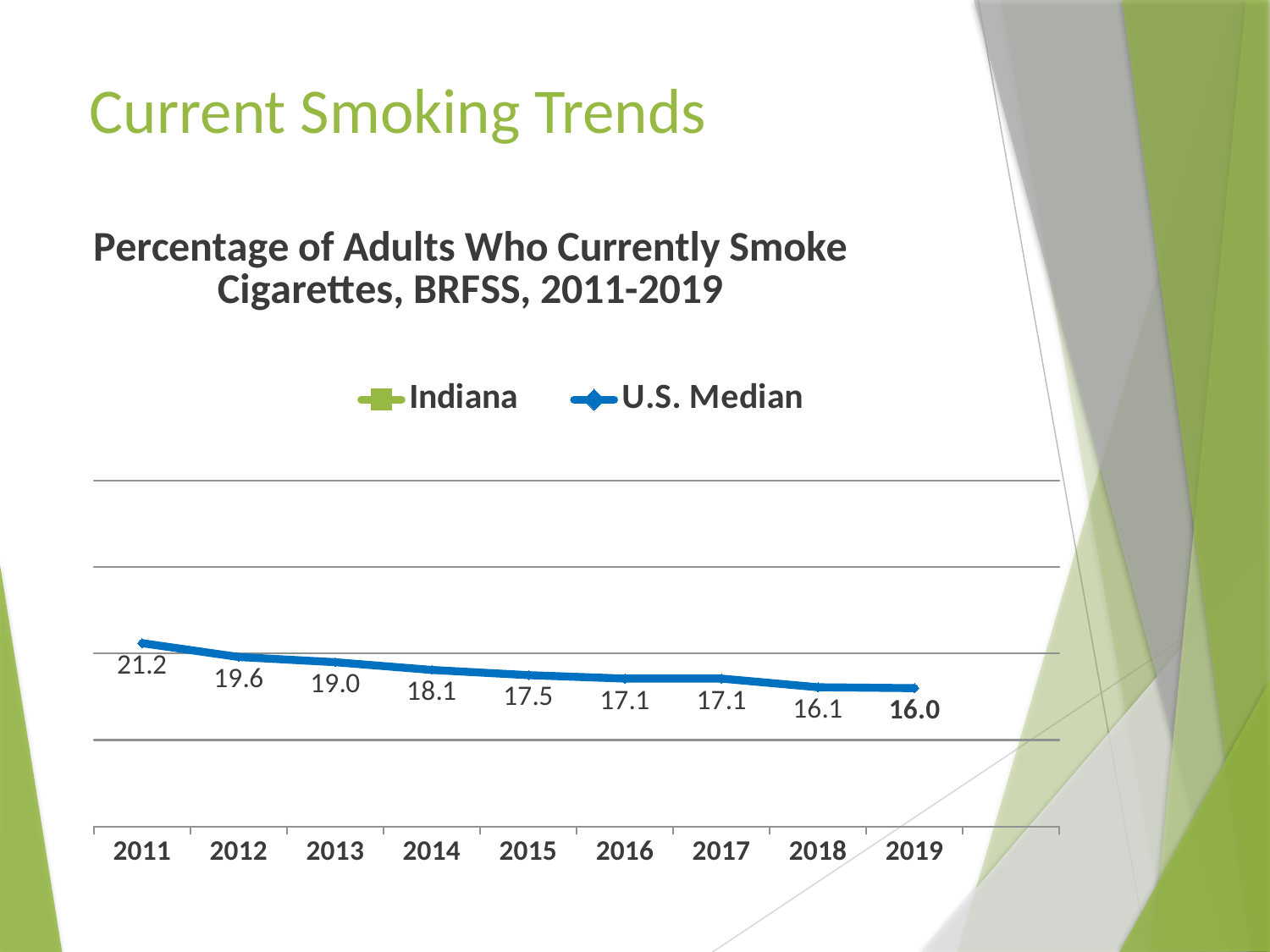
Which year has the larger labelled value, 2012 or 2018? 2012 What value is labelled for 2011 on the plotted line? 21.2 What value is labelled for 2014 on the plotted line? 18.1 What value is labelled for 2019 on the plotted line? 16.0 How many series does the legend list? 2 Which year has the highest labelled value? 2011 What is the difference between the labelled values for 2011 and 2019? 5.2 Which year has the lowest labelled value? 2019 What are the two series named in the legend? Indiana and U.S. Median How many years are shown on the x axis? 9 What kind of chart is shown? line chart Do the labelled values rise or fall from 2011 to 2019? fall